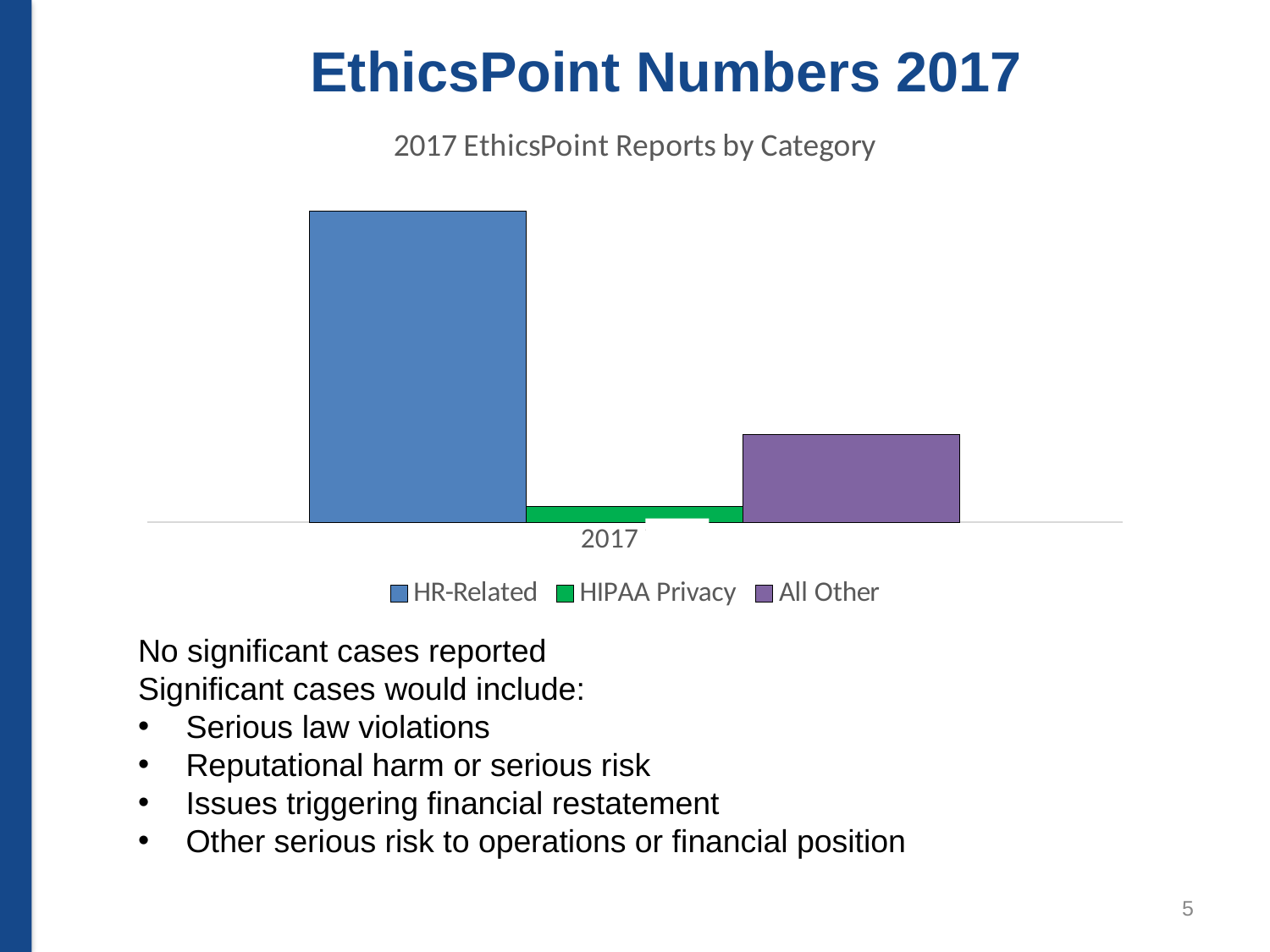
What kind of chart is shown on the slide? bar chart Which is larger, the bar for HR-Related or the bar for All Other? HR-Related Which is larger, the bar for All Other or the bar for HIPAA Privacy? All Other Which series is shown in green in the chart? HIPAA Privacy What is the category label shown on the x axis? 2017 What is the title of the chart? 2017 EthicsPoint Reports by Category Which series has the lowest bar in the chart? HIPAA Privacy Which series has the highest bar in the chart? HR-Related How many categories are shown on the x axis of the chart? 1 How many series does the chart legend list? 3